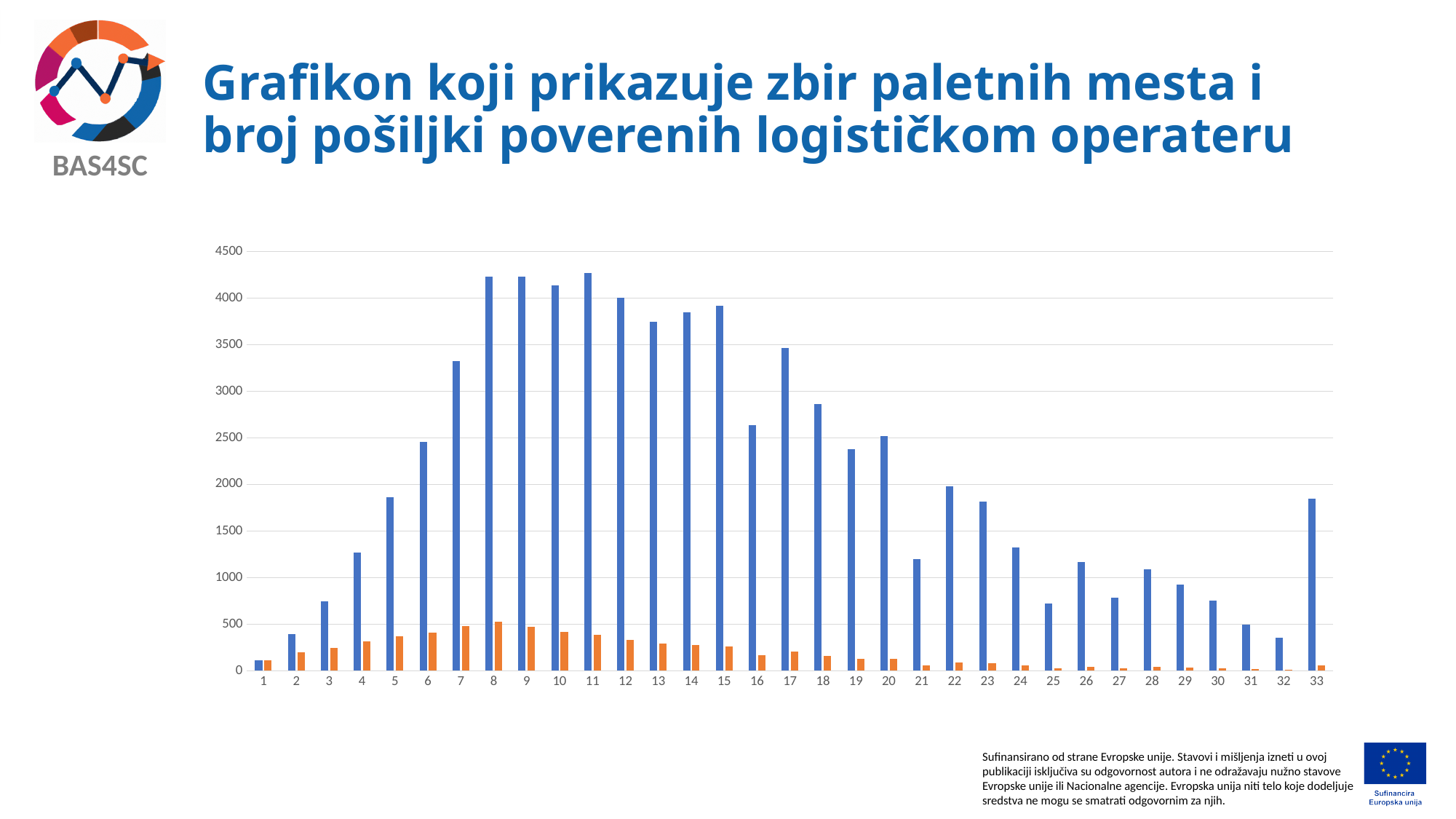
Is the blue bar for category 7 greater or less than 3000? greater Which category has the lowest blue bar in the chart? 1 Do the blue bars generally rise or fall from category 11 to category 32? fall Is the orange bar for category 1 greater or less than 500? less Which category has the highest orange bar in the chart? 8 Which has the larger blue bar, category 5 or category 20? 20 Is the blue bar for category 33 greater or less than 1500? greater What kind of chart is shown on the slide? bar chart How many categories are shown along the x axis of the chart? 33 What two colours are used for the bars in the chart? blue and orange